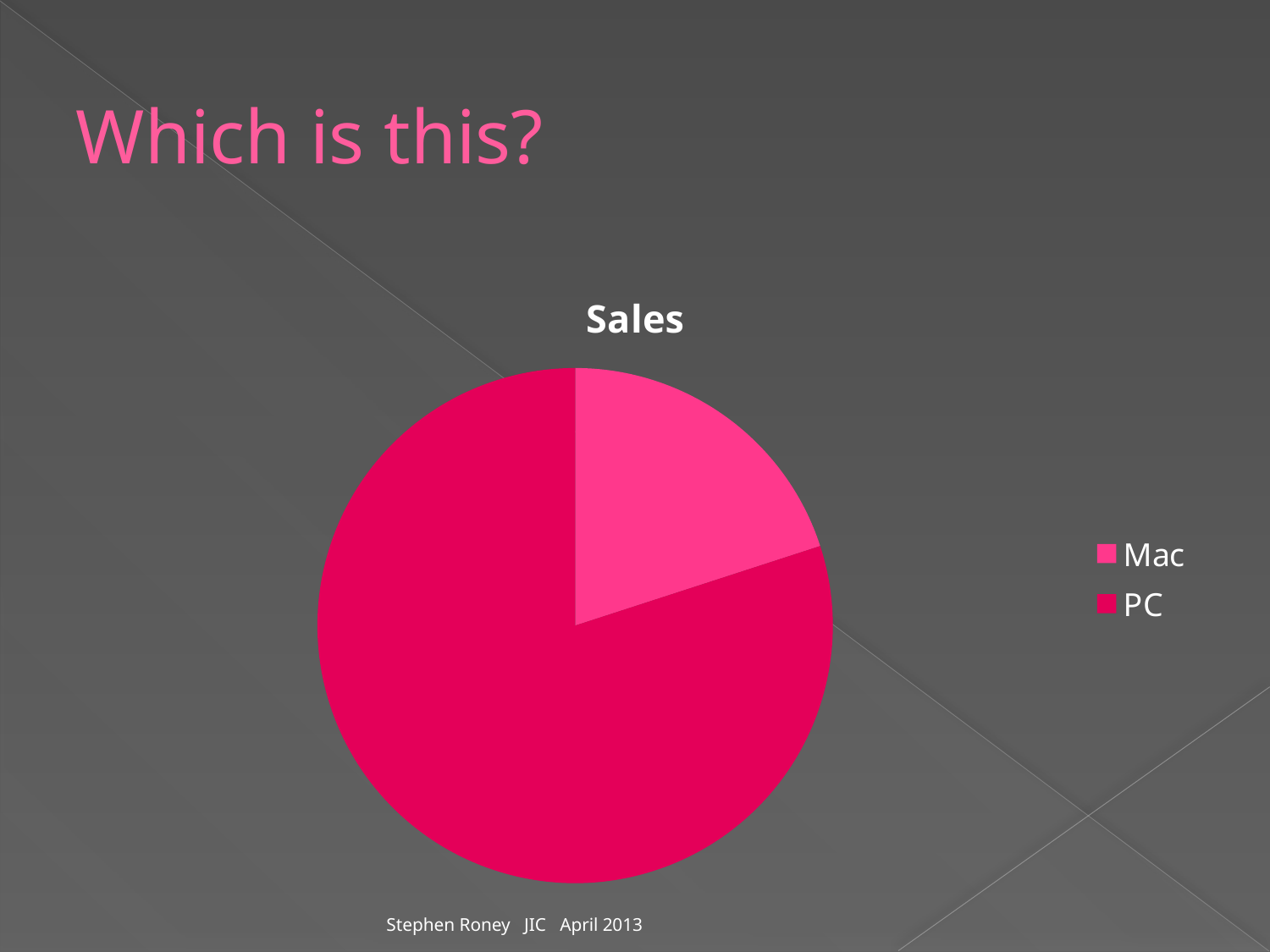
Which category has the largest slice of the pie? PC What is the title of the chart? Sales What kind of chart is shown on the slide? pie chart Which category has the smallest slice of the pie? Mac How many entries does the legend list? 2 Which legend entry is shown in the lighter pink colour? Mac Which slice is larger, Mac or PC? PC How many slices does the pie chart have? 2